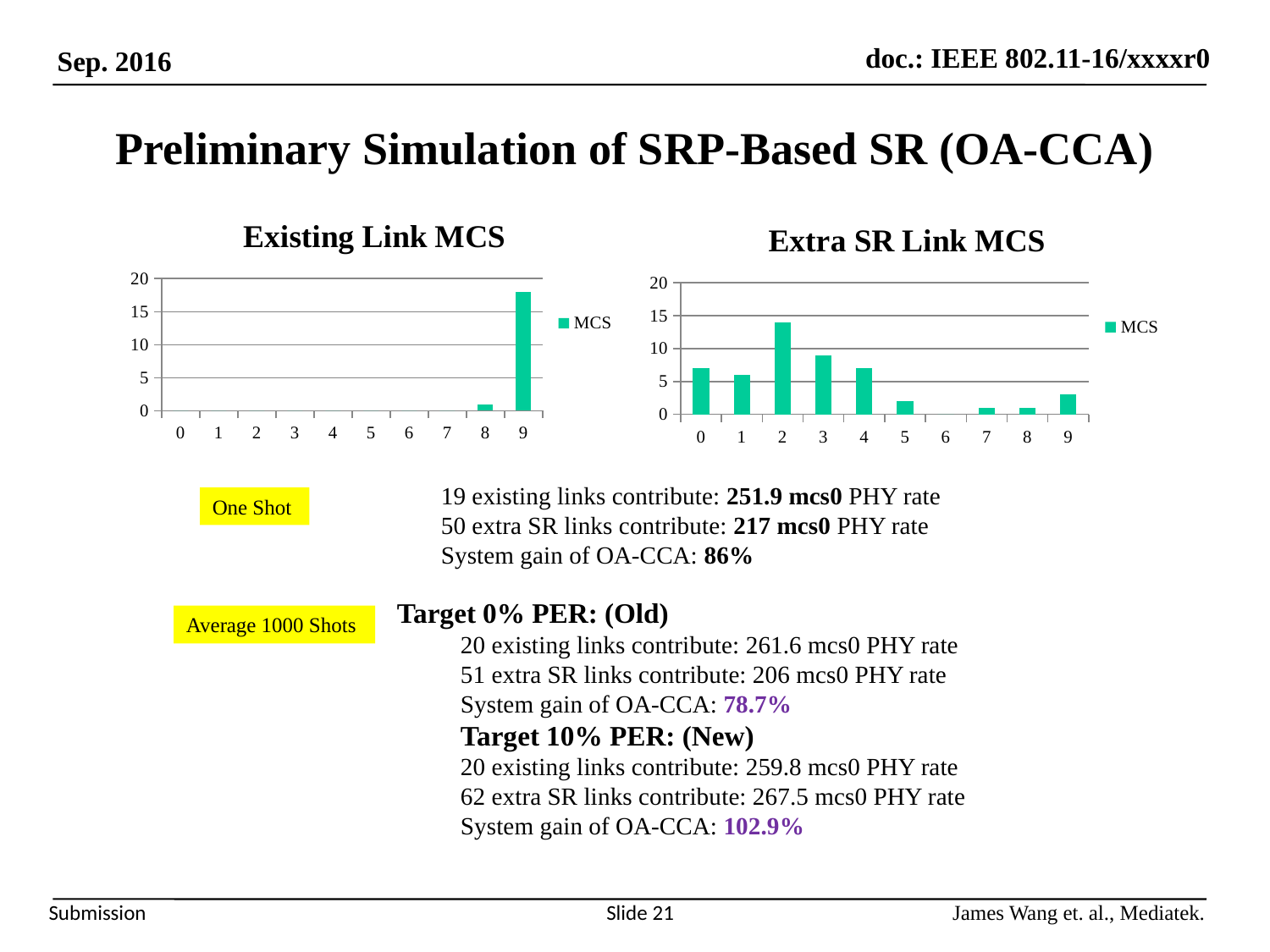
In the Extra SR Link MCS chart, is the value for MCS 0 greater or less than 5? greater In the Extra SR Link MCS chart, which is larger, the value for MCS 2 or the value for MCS 3? MCS 2 In the Existing Link MCS chart, is the value for MCS 9 greater or less than 15? greater How many series does the legend of the Existing Link MCS chart list? 1 In the Extra SR Link MCS chart, which MCS category has no bar at all (the lowest value)? 6 What kind of chart is the Existing Link MCS chart? bar chart What is the legend entry shown on the Extra SR Link MCS chart? MCS In the Existing Link MCS chart, which MCS category has the highest bar? 9 In the Extra SR Link MCS chart, which MCS category has the highest bar? 2 In the Extra SR Link MCS chart, is the value for MCS 2 greater or less than 10? greater How many MCS categories are shown on the x axis of the Extra SR Link MCS chart? 10